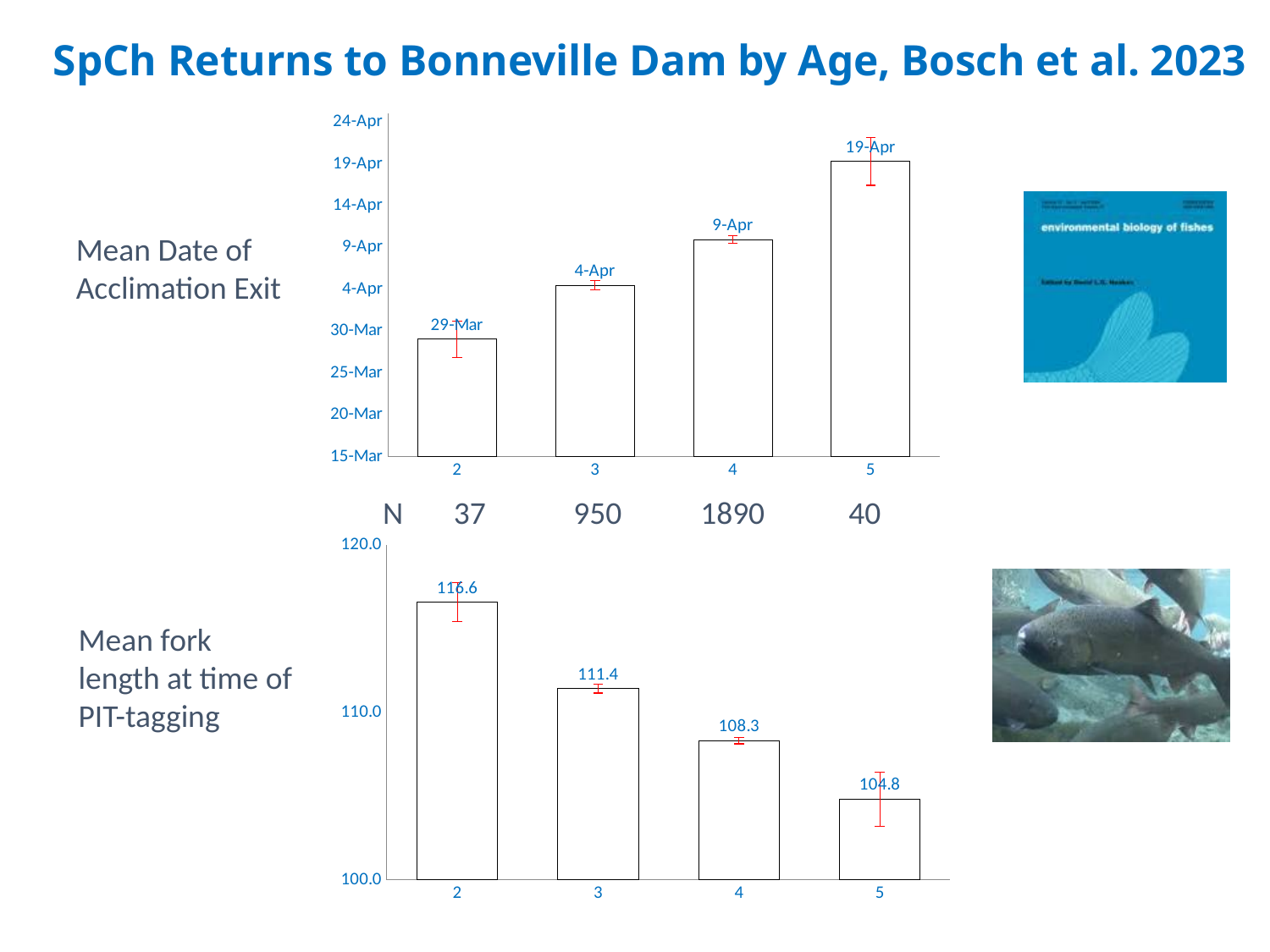
In the Mean Date of Acclimation Exit chart, what is the value for age 2? 29-Mar In the Mean fork length at time of PIT-tagging chart, what is the value for age 5? 104.8 What kind of chart is the Mean fork length at time of PIT-tagging chart? bar chart In the Mean fork length at time of PIT-tagging chart, which is larger, the value for age 4 or the value for age 5? age 4 In the Mean Date of Acclimation Exit chart, how many age categories are shown? 4 In the Mean Date of Acclimation Exit chart, do the values rise or fall as age increases? rise In the Mean fork length at time of PIT-tagging chart, what is the difference between the values for age 2 and age 3? 5.2 In the Mean fork length at time of PIT-tagging chart, is the value for age 4 greater or less than 110.0? less In the Mean fork length at time of PIT-tagging chart, which age has the lowest mean fork length? 5 In the Mean fork length at time of PIT-tagging chart, what is the value for age 3? 111.4 In the Mean Date of Acclimation Exit chart, which age has the latest mean exit date? 5 In the Mean Date of Acclimation Exit chart, what is the value for age 5? 19-Apr